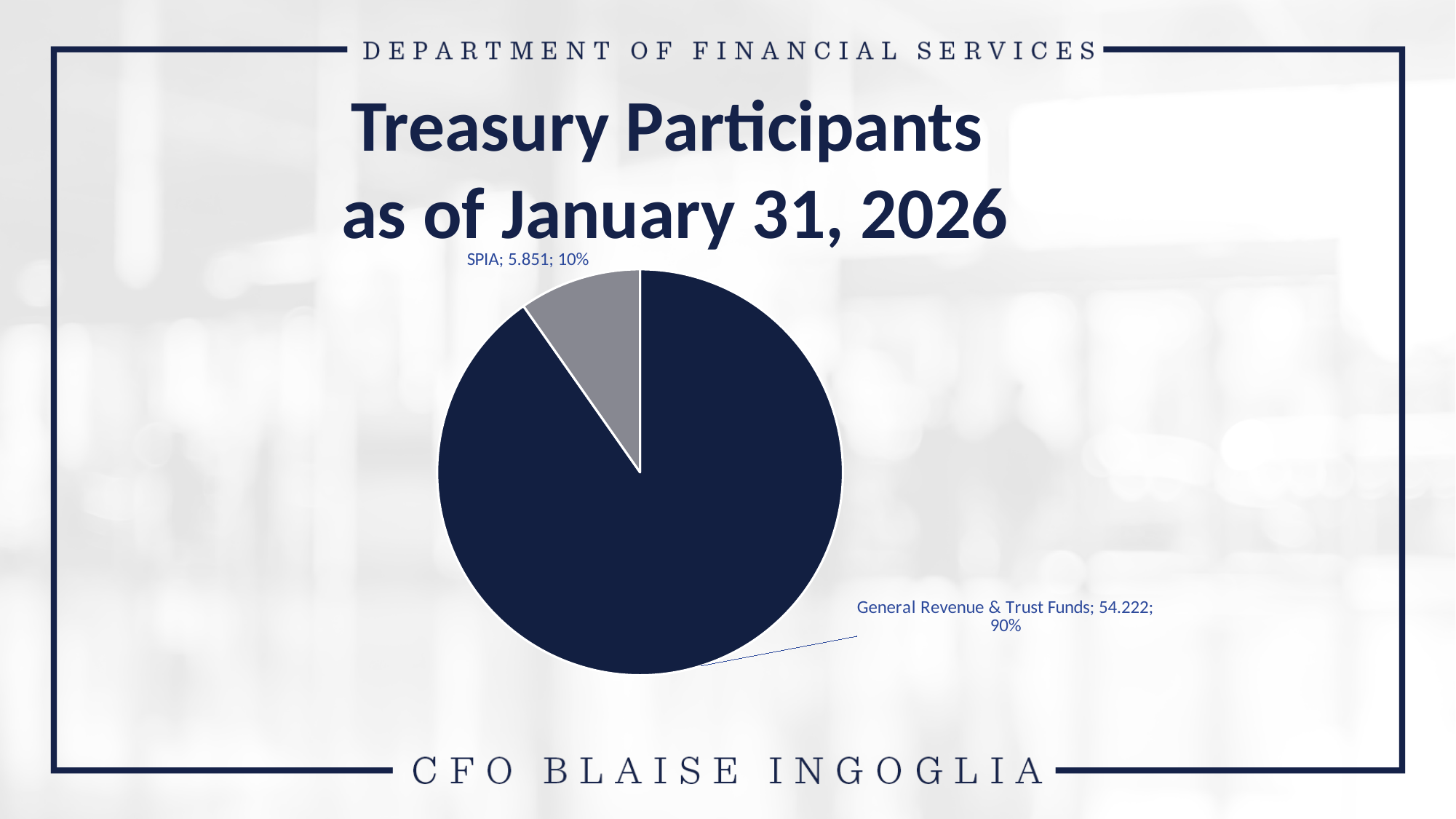
What share of the pie does General Revenue & Trust Funds represent? 90% What colour is the SPIA slice? Gray How many slices does the pie chart have? 2 What share of the pie does SPIA represent? 10% What is the value for SPIA? 5.851 What is the difference between the values for General Revenue & Trust Funds and SPIA? 48.371 Which is larger, the value for SPIA or the value for General Revenue & Trust Funds? General Revenue & Trust Funds What kind of chart is shown on the slide? Pie chart Which category has the largest slice? General Revenue & Trust Funds What is the title of the chart? Treasury Participants as of January 31, 2026 Which category has the smallest slice? SPIA What is the value for General Revenue & Trust Funds? 54.222